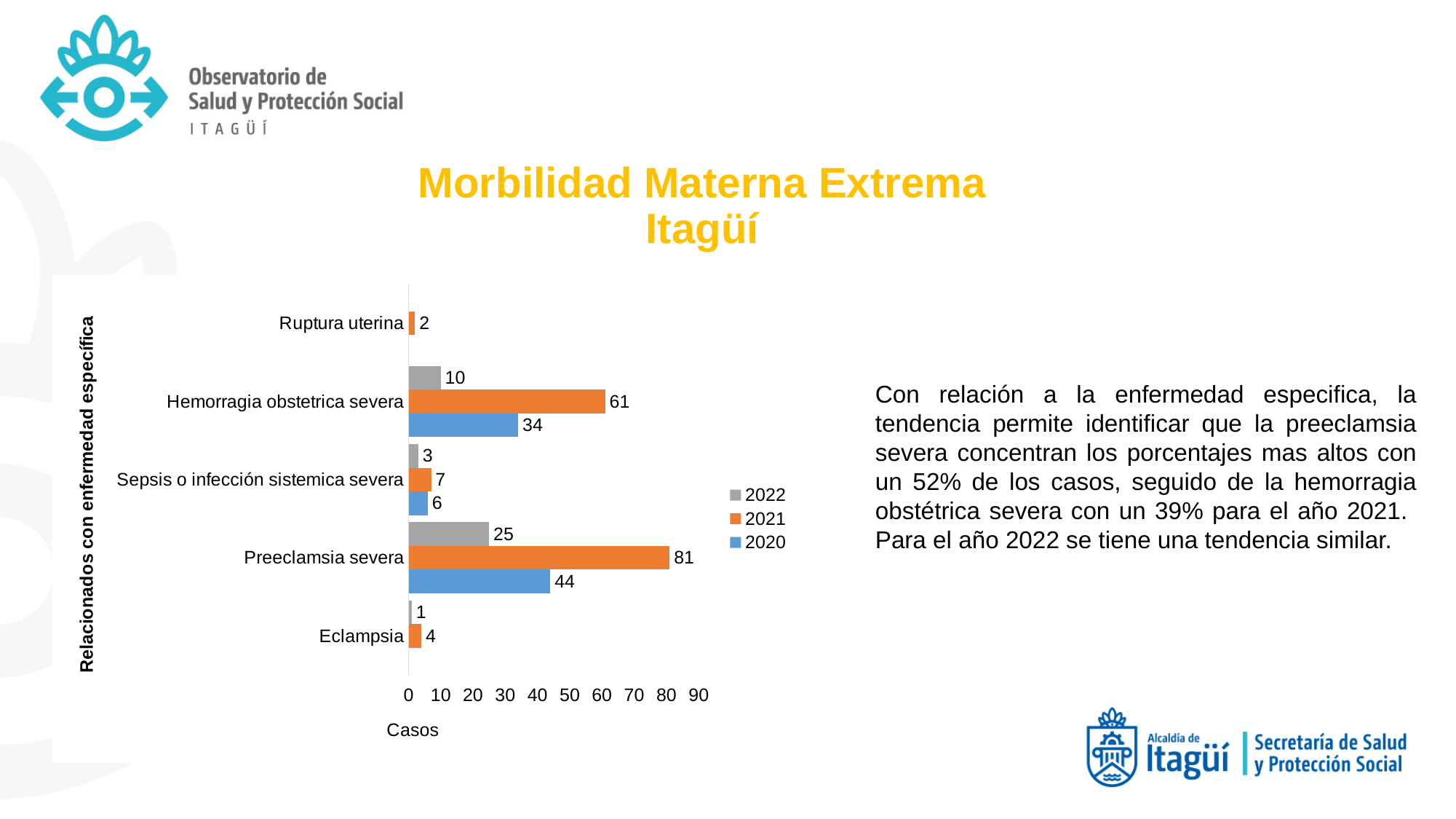
Which category has the highest value in the 2021 series? Preeclamsia severa Which is larger: the 2021 value for Hemorragia obstetrica severa or the 2020 value for Preeclamsia severa? 2021 value for Hemorragia obstetrica severa Which colour represents the 2020 series in the legend? blue What kind of chart is shown on the slide? bar chart What is the difference between the 2021 and 2020 values for Preeclamsia severa? 37 What is the value for Sepsis o infección sistemica severa in 2022? 3 What is the value for Preeclamsia severa in 2021? 81 How many categories are shown on the vertical axis of the chart? 5 Which category has the lowest value in the 2022 series? Eclampsia What is the label of the horizontal axis? Casos What is the value for Hemorragia obstetrica severa in 2020? 34 How many series does the legend list? 3